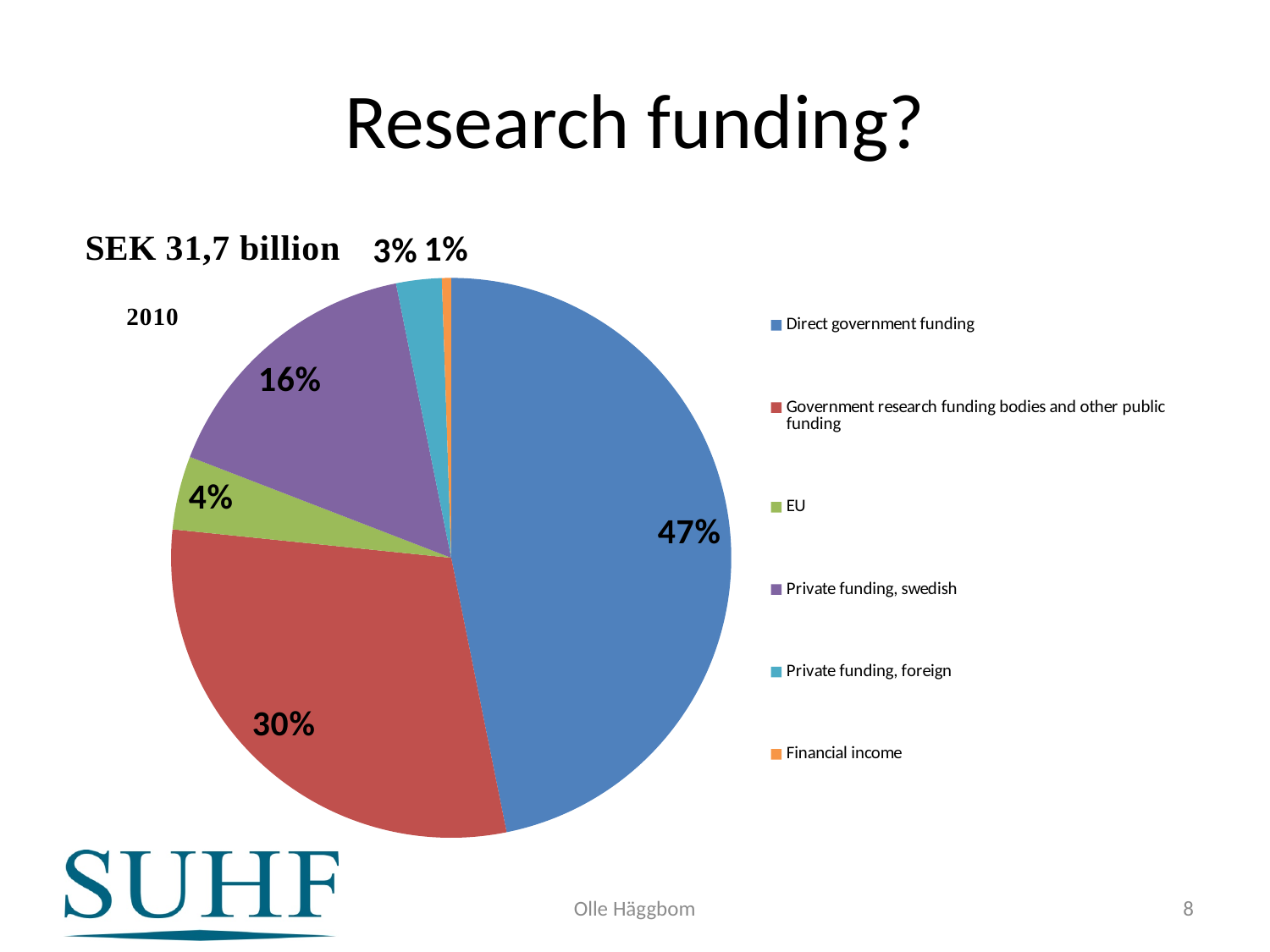
What is the difference in percentage points between Direct government funding and Government research funding bodies and other public funding? 17 What kind of chart is shown on the slide? Pie chart What share of research funding comes from Private funding, foreign? 3% What share of research funding comes from Direct government funding? 47% Which funding source has the largest share of the pie? Direct government funding What share of research funding comes from the EU? 4% Which funding source has the smallest share of the pie? Financial income How many funding sources does the legend list? 6 Which is larger: the share for Private funding, swedish or the share for EU? Private funding, swedish